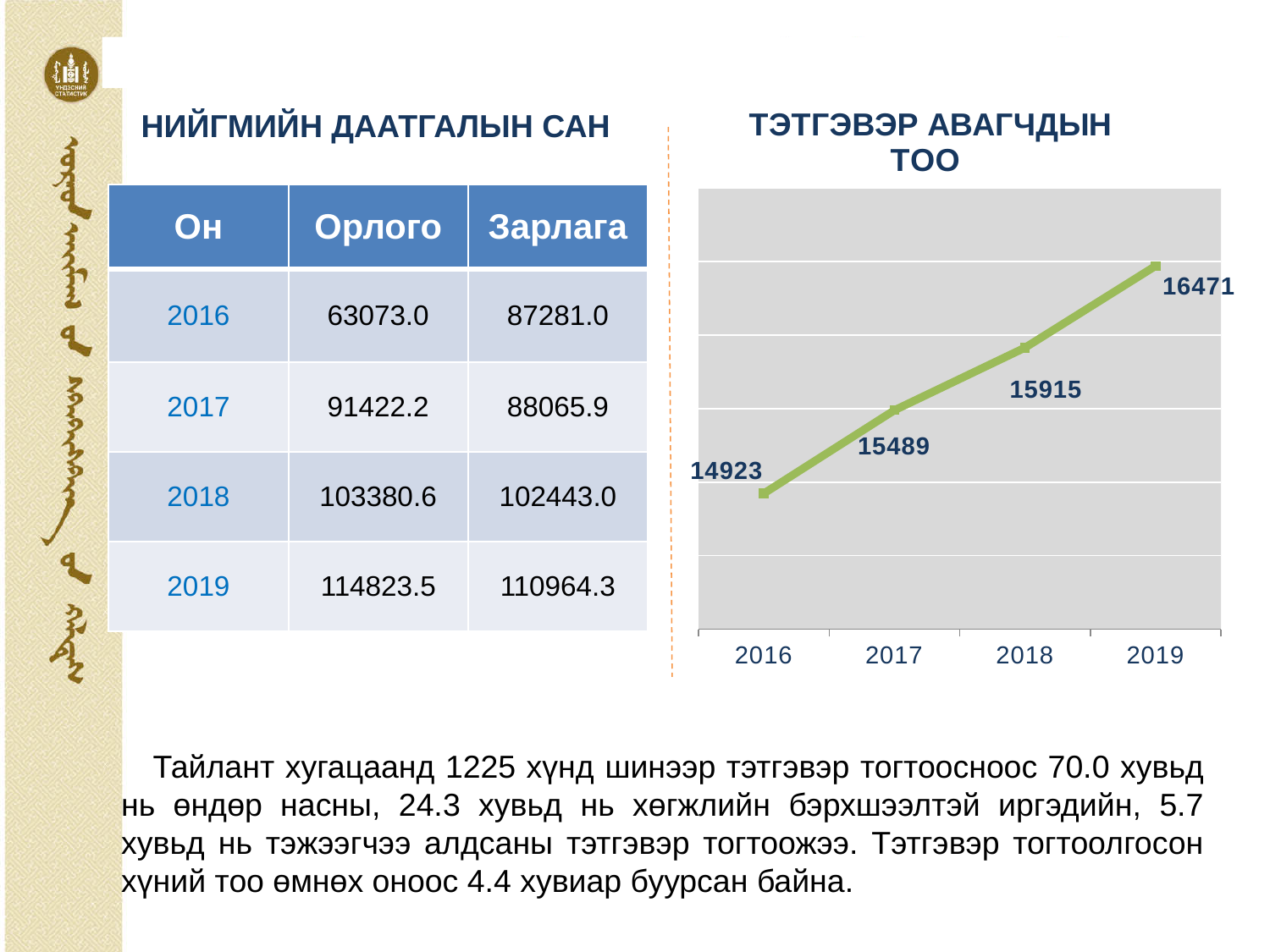
In the "ТЭТГЭВЭР АВАГЧДЫН ТОО" chart, which is larger, the value for 2017 or the value for 2018? 2018 In the "ТЭТГЭВЭР АВАГЧДЫН ТОО" chart, what is the value for 2019? 16471 In the "ТЭТГЭВЭР АВАГЧДЫН ТОО" chart, do the values rise or fall from 2016 to 2019? rise In the "ТЭТГЭВЭР АВАГЧДЫН ТОО" chart, which year has the highest value? 2019 In the "ТЭТГЭВЭР АВАГЧДЫН ТОО" chart, what is the value for 2018? 15915 In the "ТЭТГЭВЭР АВАГЧДЫН ТОО" chart, what is the difference between the 2018 and 2017 values? 426 How many data points are plotted in the "ТЭТГЭВЭР АВАГЧДЫН ТОО" chart? 4 In the "ТЭТГЭВЭР АВАГЧДЫН ТОО" chart, what is the value for 2017? 15489 In the "ТЭТГЭВЭР АВАГЧДЫН ТОО" chart, what is the difference between the 2019 and 2016 values? 1548 In the "ТЭТГЭВЭР АВАГЧДЫН ТОО" chart, which year has the lowest value? 2016 In the "ТЭТГЭВЭР АВАГЧДЫН ТОО" chart, what is the value for 2016? 14923 What type of chart is shown under the title "ТЭТГЭВЭР АВАГЧДЫН ТОО"? line chart